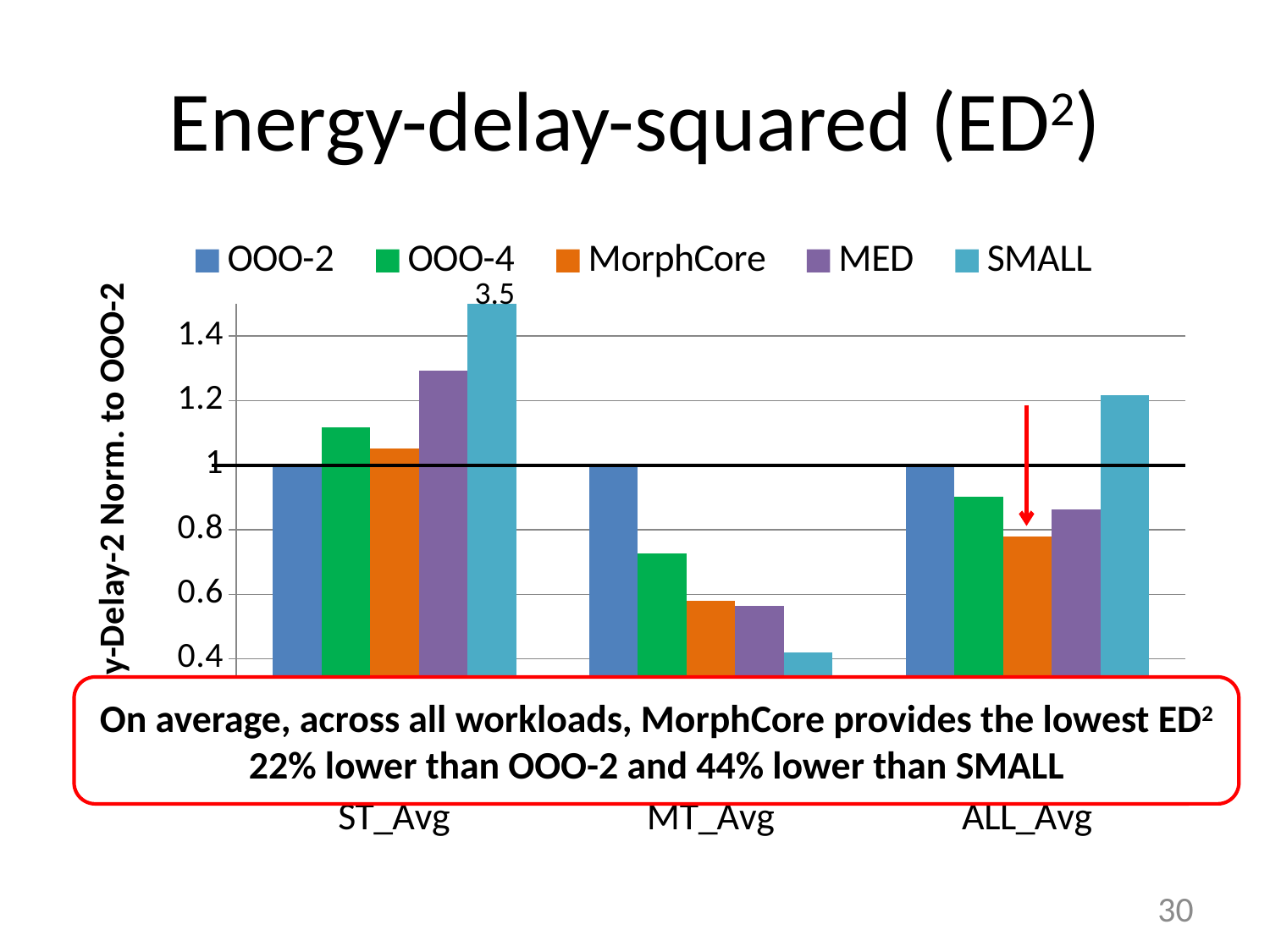
How many series does the legend list? 5 Which series has the lowest value for MT_Avg? SMALL What is the value of the SMALL bar for ST_Avg? 3.5 What colour represents MorphCore in the legend? orange For MT_Avg, which is larger: OOO-4 or MorphCore? OOO-4 What kind of chart is shown on the slide? bar chart Which series has the lowest value for ALL_Avg? MorphCore Which series has the highest value for ST_Avg? SMALL Is the value for SMALL at MT_Avg greater or less than 0.6? less How many categories are shown on the x axis? 3 Is the value for MED at ST_Avg greater or less than 1.2? greater What is the value of the OOO-2 bar for ALL_Avg? 1